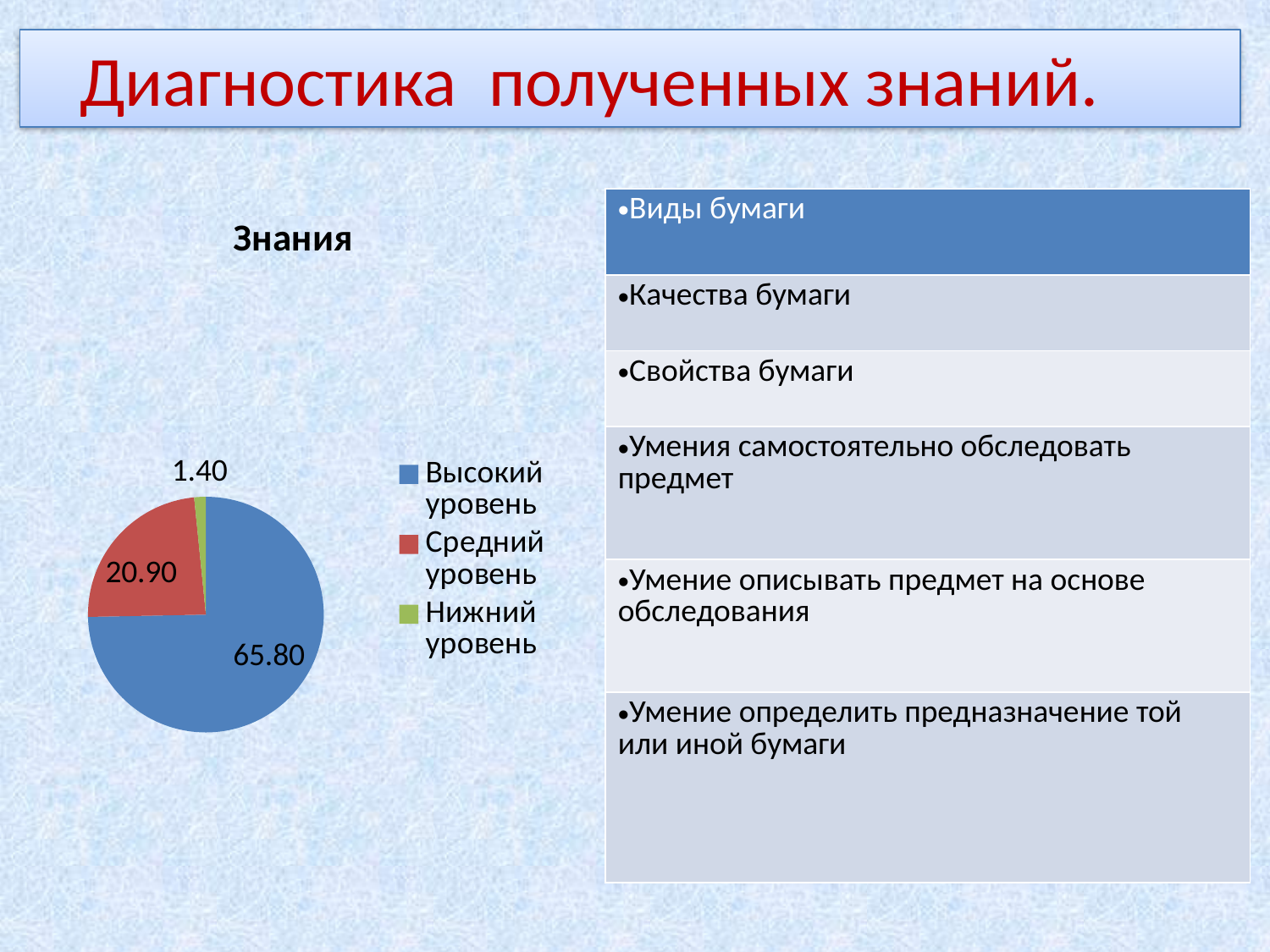
What is the difference between the values for Высокий уровень and Средний уровень? 44.90 What is the title of the chart? Знания What is the value for Средний уровень? 20.90 What colour is the slice for Средний уровень? red What is the difference between the values for Средний уровень and Нижний уровень? 19.50 Which category has the smallest slice? Нижний уровень Which is larger, the value for Средний уровень or Нижний уровень? Средний уровень What is the value for Нижний уровень? 1.40 What is the value for Высокий уровень? 65.80 What kind of chart is shown on the slide? pie chart How many categories does the pie chart have? 3 Which category has the largest slice? Высокий уровень